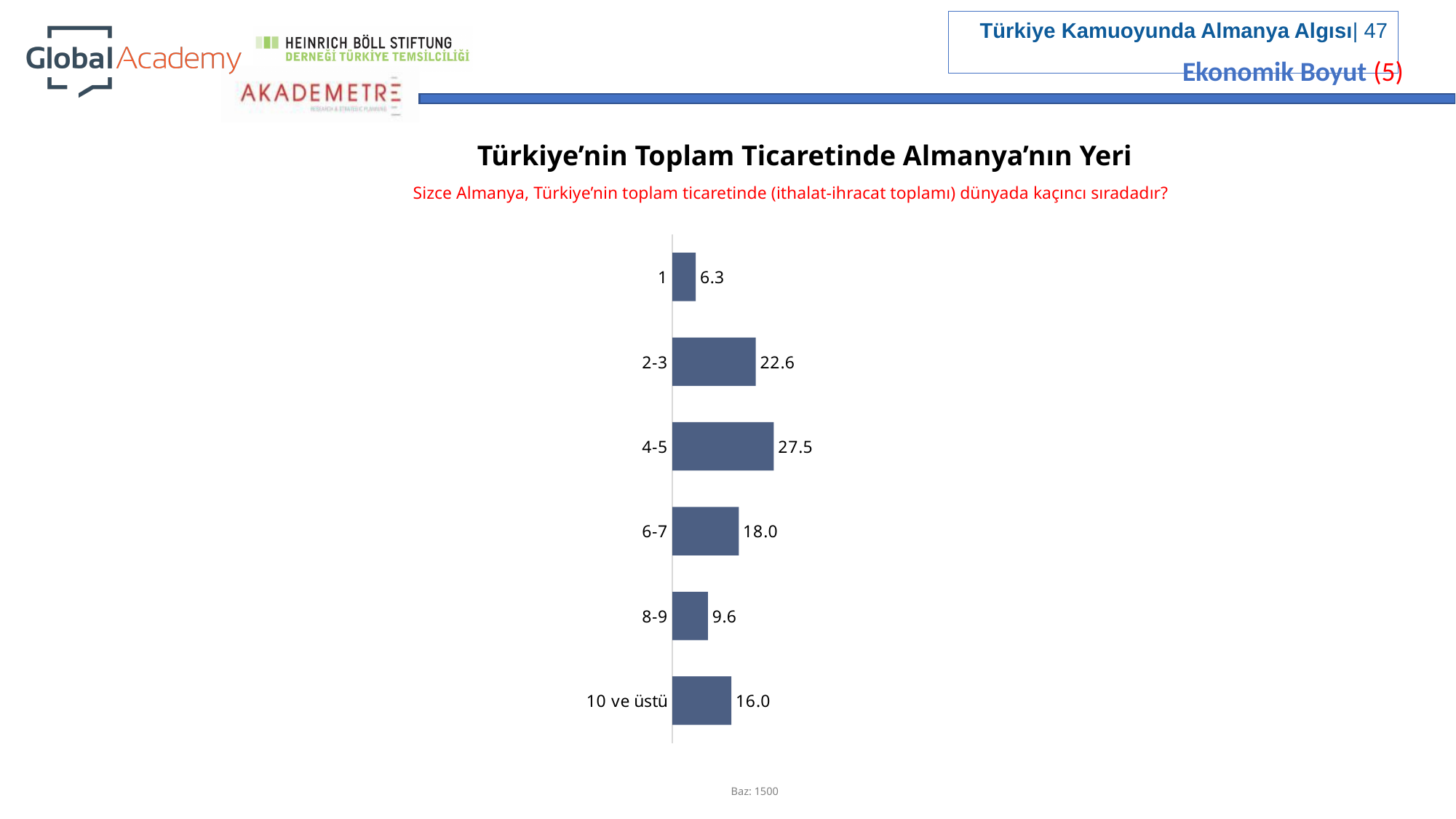
Which category has the lowest value? 1 What is the title of the chart? Türkiye'nin Toplam Ticaretinde Almanya'nın Yeri How many categories are shown in the chart? 6 What is the value for the category "10 ve üstü"? 16.0 What is the value for the category "1"? 6.3 What kind of chart is shown on the slide? Bar chart What is the difference between the values for "4-5" and "2-3"? 4.9 Which category has the highest value? 4-5 What is the difference between the values for "6-7" and "8-9"? 8.4 Which is larger, the value for "2-3" or the value for "6-7"? 2-3 What is the value for the category "4-5"? 27.5 Which is larger, the value for "8-9" or the value for "10 ve üstü"? 10 ve üstü